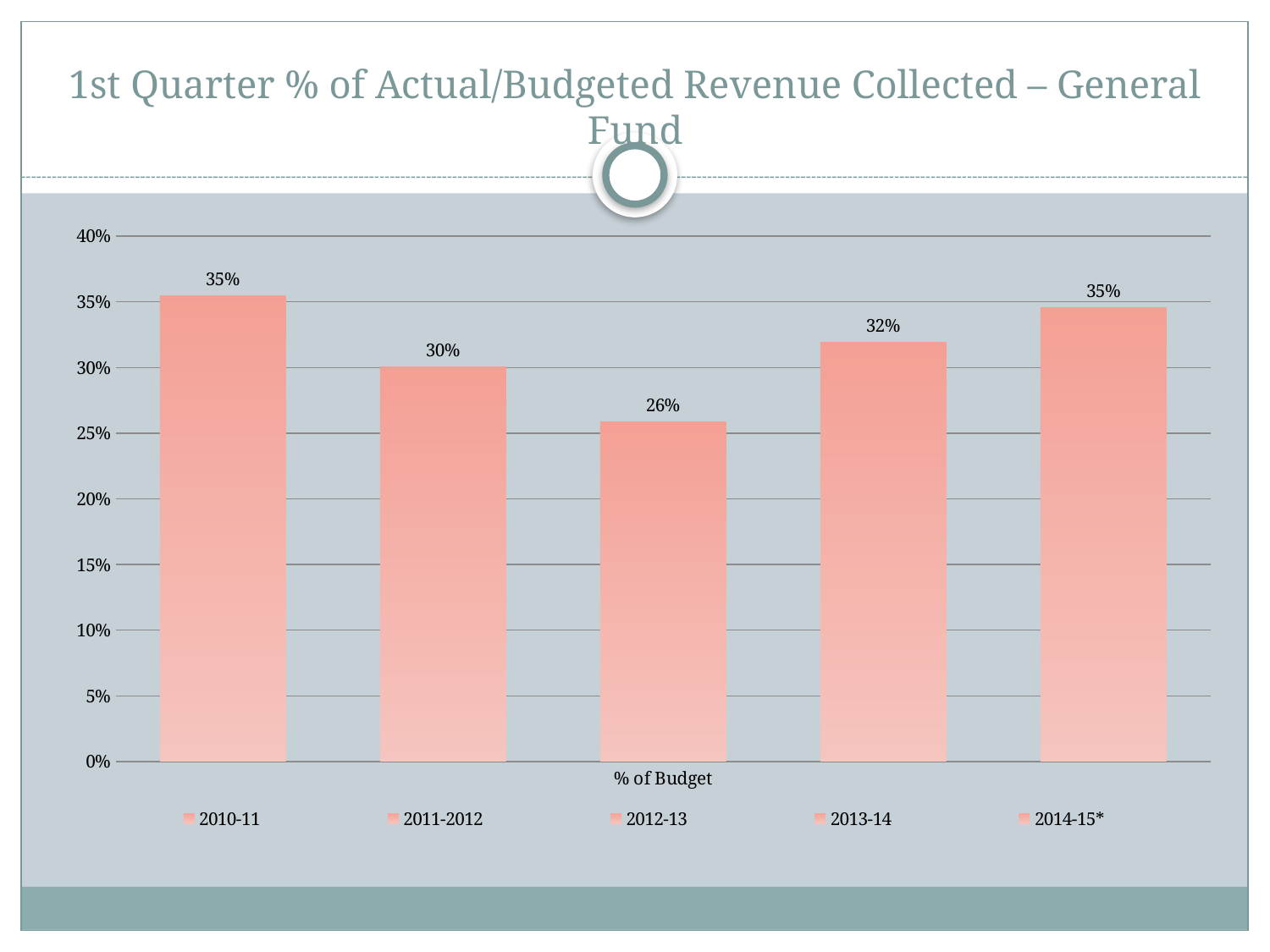
Which year has the lowest percentage of budgeted revenue collected? 2012-13 What kind of chart is shown on the slide? bar chart Which is larger, the value for 2013-14 or the value for 2011-2012? 2013-14 How many entries does the legend list? 5 What is the value for 2013-14? 32% Is the value for 2013-14 greater or less than 30%? greater What label appears under the bars on the horizontal axis? % of Budget What is the value for 2011-2012? 30% What is the difference between the values for 2010-11 and 2012-13? 9 percentage points What is the value for 2010-11? 35% How many bars are plotted on the chart? 5 What is the value for 2012-13? 26%